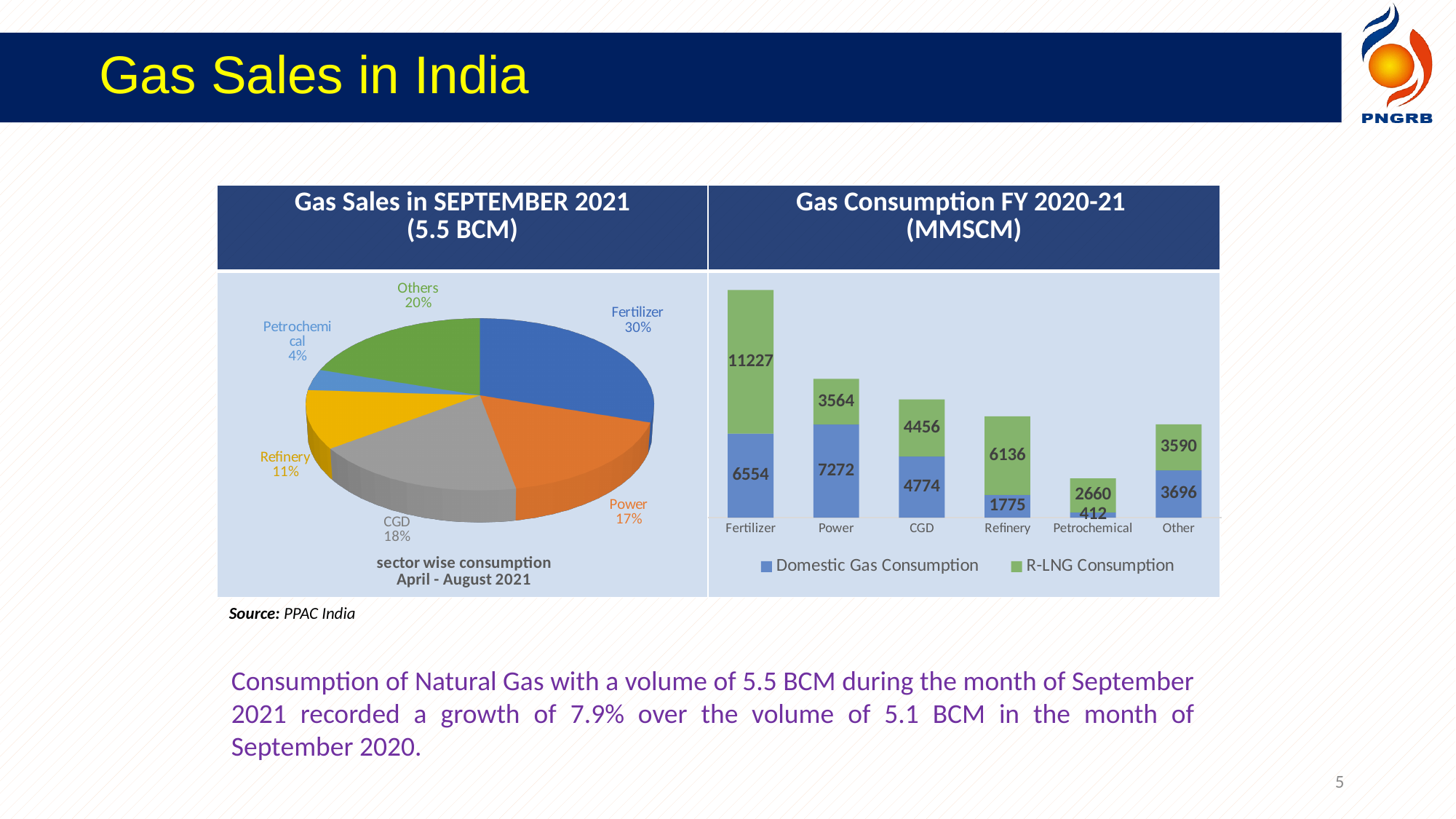
In the Gas Consumption FY 2020-21 chart, what is the total consumption for Refinery? 7911 In the Gas Consumption FY 2020-21 chart, what is the Domestic Gas Consumption for Power? 7272 What type of chart is the Gas Consumption FY 2020-21 chart? Stacked bar chart In the Gas Sales in SEPTEMBER 2021 pie chart, how many sectors are shown? 6 In the Gas Consumption FY 2020-21 chart, what is the difference between R-LNG Consumption and Domestic Gas Consumption for Petrochemical? 2248 In the Gas Consumption FY 2020-21 chart, which sector has the lowest Domestic Gas Consumption? Petrochemical In the Gas Sales in SEPTEMBER 2021 pie chart, which sector has the smallest share? Petrochemical In the Gas Sales in SEPTEMBER 2021 pie chart, which sector has the largest share? Fertilizer In the Gas Consumption FY 2020-21 chart, how many series does the legend list? 2 In the Gas Sales in SEPTEMBER 2021 pie chart, what share does Fertilizer have? 30% In the Gas Consumption FY 2020-21 chart, what is the R-LNG Consumption for Fertilizer? 11227 In the Gas Sales in SEPTEMBER 2021 pie chart, which has a larger share, CGD or Power? CGD